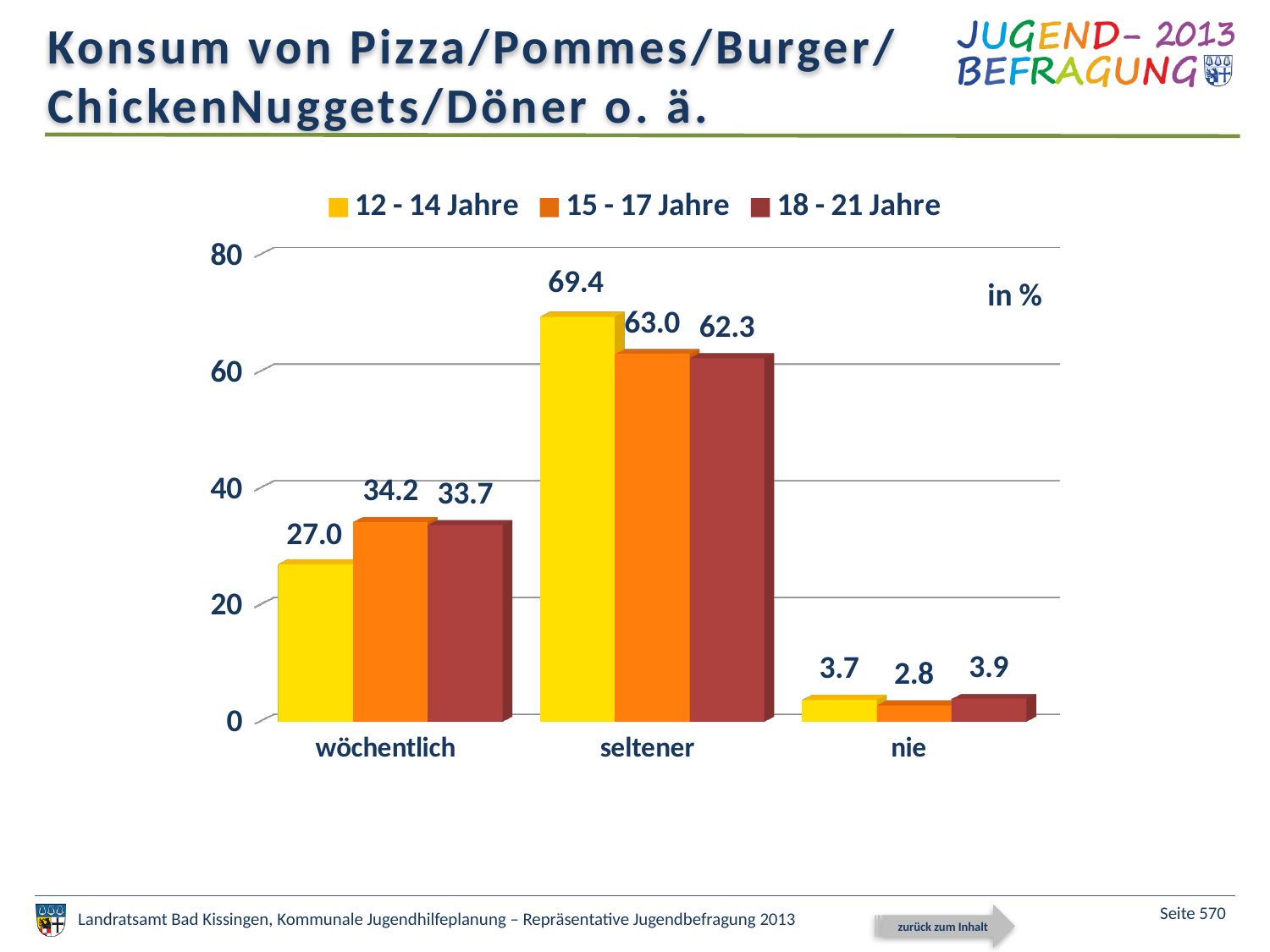
Which category has the lowest value for the 18 - 21 Jahre series? nie Is the value for 18 - 21 Jahre in the wöchentlich category greater or less than 40? less What is the value for the 15 - 17 Jahre series in the nie category? 2.8 In the wöchentlich category, which is larger: the 12 - 14 Jahre value or the 15 - 17 Jahre value? 15 - 17 Jahre How many series does the legend list? 3 What kind of chart is shown on the slide? bar chart How many categories are shown on the x axis? 3 Which category has the highest value for the 12 - 14 Jahre series? seltener What is the value for the 12 - 14 Jahre series in the wöchentlich category? 27.0 What is the difference between the 12 - 14 Jahre and 15 - 17 Jahre values in the seltener category? 6.4 What unit label is shown in the chart area? in % What is the value for the 18 - 21 Jahre series in the seltener category? 62.3